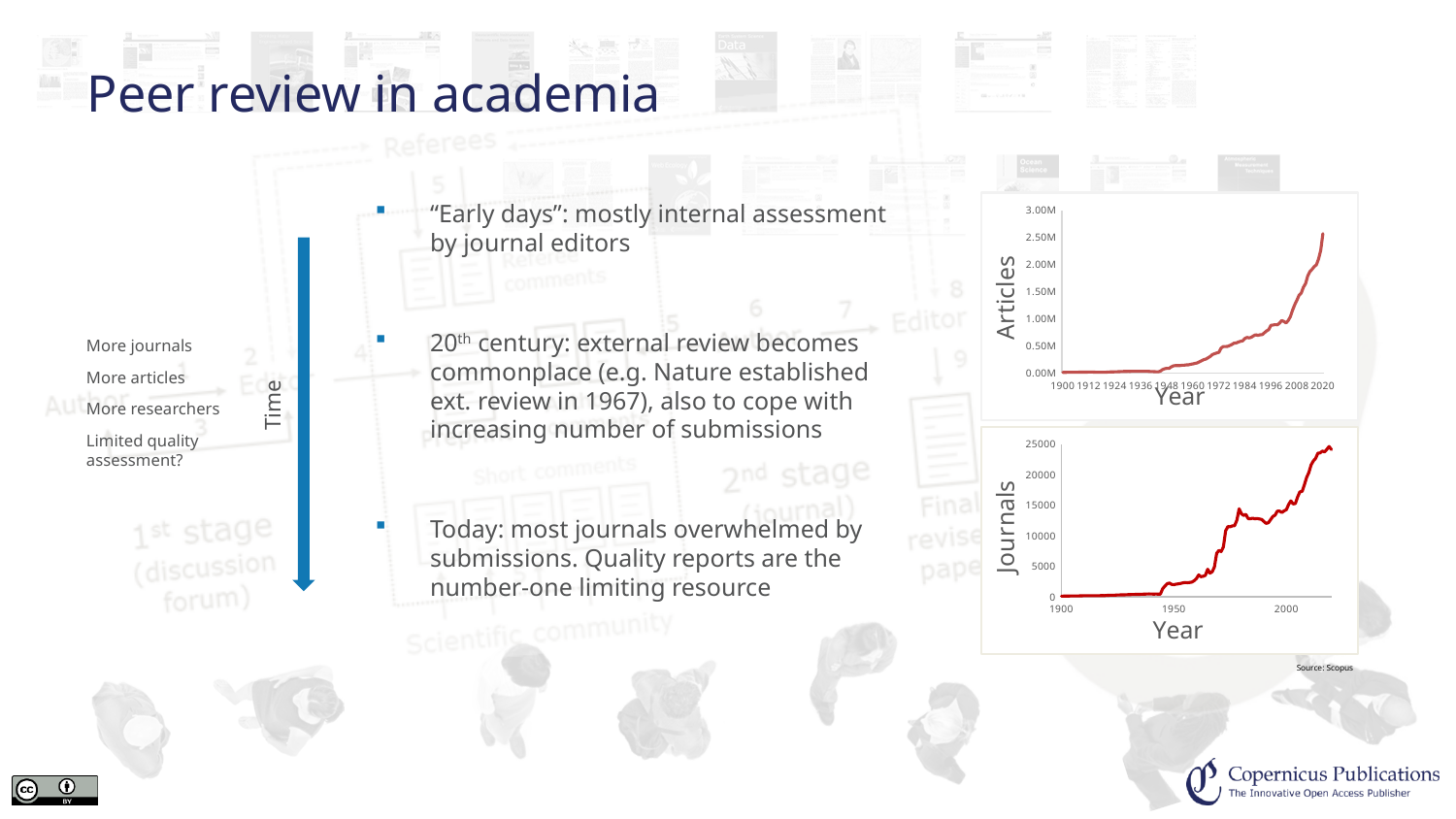
In the top chart, which year has the higher number of articles, 1936 or 2008? 2008 In the bottom chart, do the number of journals rise or fall from 1900 to the end of the series? rise In the top chart, do the number of articles rise or fall as the year increases? rise What is the y-axis label of the top chart? Articles In the top chart, is the value for articles in 1960 greater or less than 0.50M? less In the bottom chart, is the value for journals at the end of the series greater or less than 20000? greater What kind of chart is the top chart (Articles vs Year)? line chart What is the x-axis label of the bottom chart? Year How many charts are shown on the slide? 2 In the bottom chart, is the value for journals in 1950 greater or less than 5000? less What kind of chart is the bottom chart (Journals vs Year)? line chart